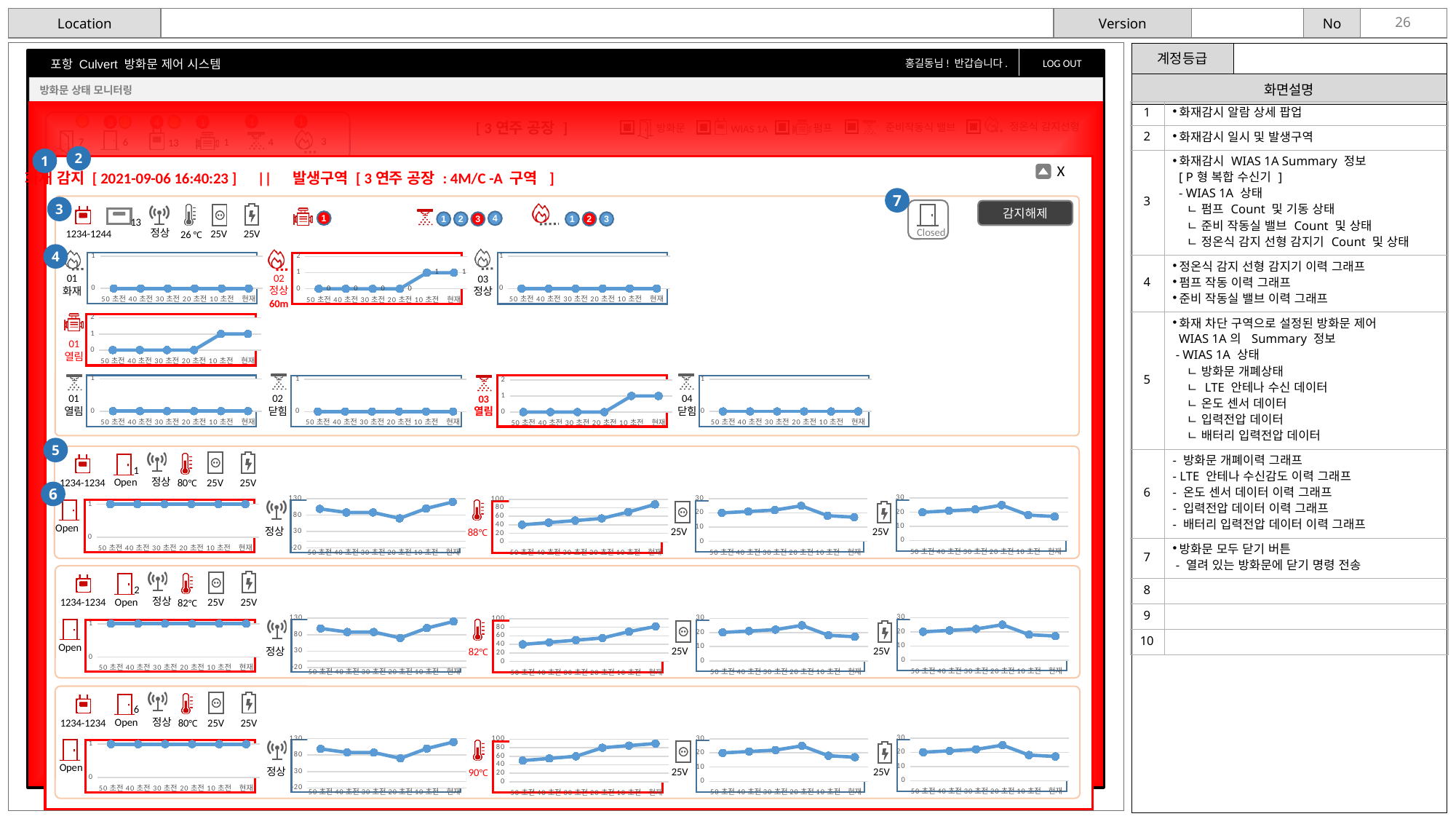
In the first door section (door 1), is the value at 현재 on the battery voltage chart (25V, rightmost) greater or less than 10? greater In the first door section (door 1, 88℃), is the temperature chart's value at 50 초전 greater or less than 60? less What is the rightmost x-axis label on the history charts? 현재 In the top section, does the valve chart labeled "03 열림" rise or fall from 50 초전 to 현재? rise In the top section, does the pump chart labeled "01 열림" rise, fall, or stay flat from 50 초전 to 현재? rise In the top section, what value does the chart labeled "02 정상" show at 현재? 1 What kind of chart is used for the history graphs on the slide? line chart What is the top y-axis tick value on the temperature history charts in the door sections? 100 In the top section, does the chart labeled "02 정상" rise or fall from 50 초전 to 현재? rise In the first door section (door 1, 88℃), is the temperature chart's value at 현재 greater or less than 60? greater In the top section, what value does the chart labeled "02 정상" show at 50 초전? 0